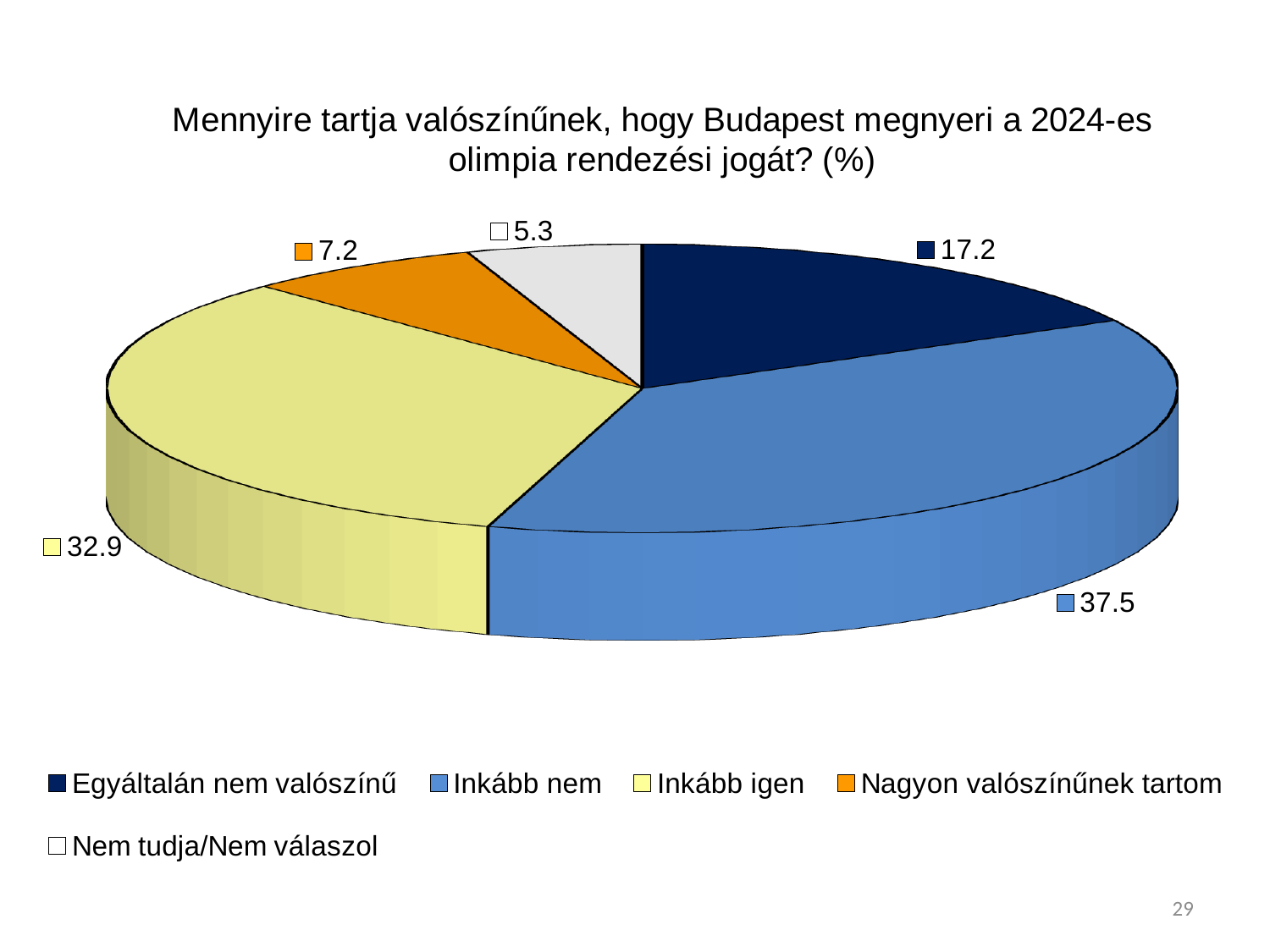
Which category has the largest slice of the pie? Inkább nem What is the difference between the values for "Nagyon valószínűnek tartom" and "Nem tudja/Nem válaszol"? 1.9 What is the difference between the values for "Inkább nem" and "Inkább igen"? 4.6 What is the value for "Inkább nem"? 37.5 What is the value for "Egyáltalán nem valószínű"? 17.2 Which category has the smallest slice of the pie? Nem tudja/Nem válaszol What colour is the slice for "Nagyon valószínűnek tartom"? orange Which is larger, the value for "Egyáltalán nem valószínű" or the value for "Nagyon valószínűnek tartom"? Egyáltalán nem valószínű What is the value for "Nem tudja/Nem válaszol"? 5.3 What kind of chart is shown on the slide? pie chart How many categories does the legend list? 5 What is the value for "Nagyon valószínűnek tartom"? 7.2